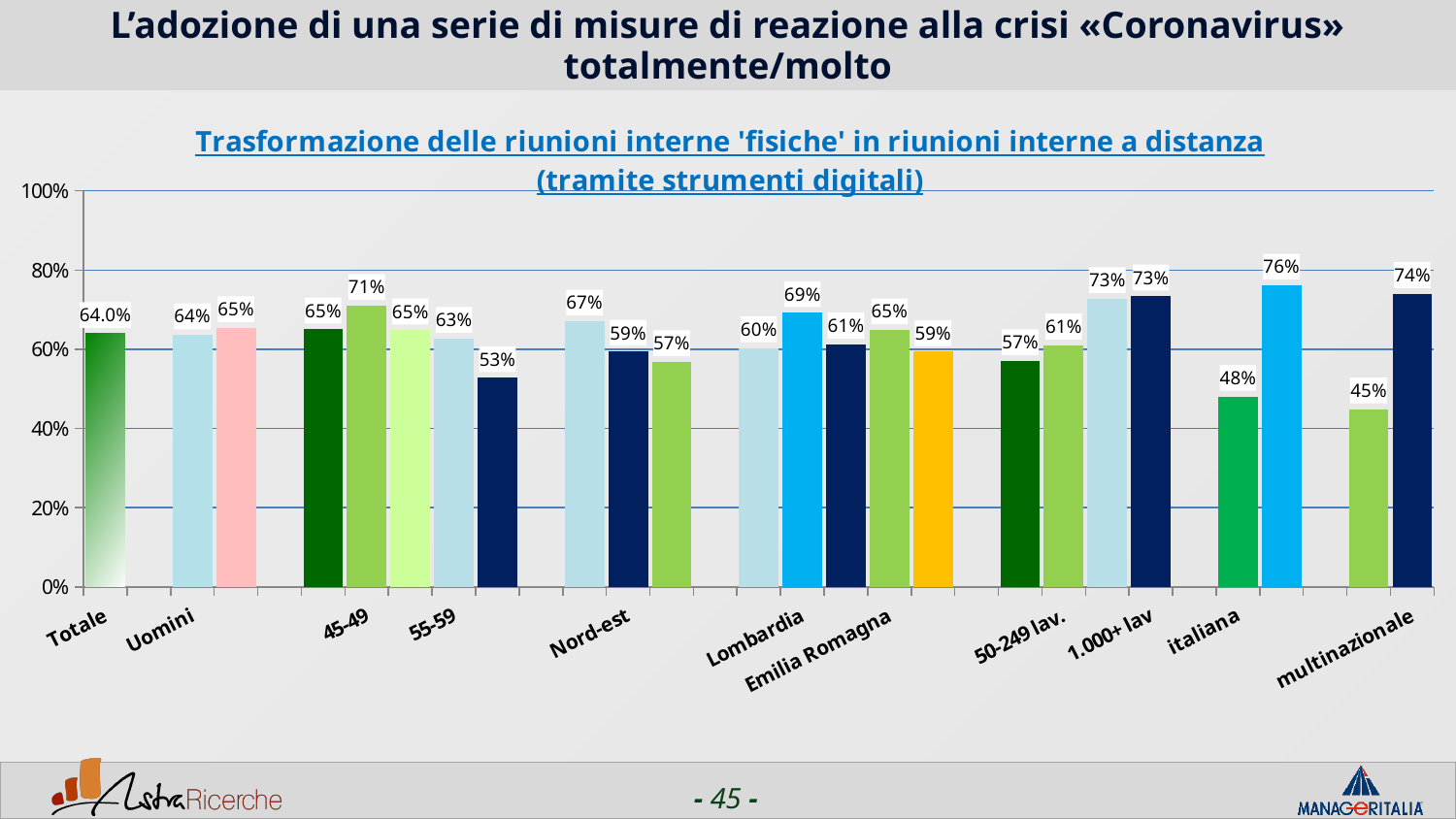
What is the difference between the values for 45-49 and 55-59? 8% What is the value for Uomini? 64% Which is larger, the value for Lombardia or the value for Nord-est? Lombardia What is the title of the chart? Trasformazione delle riunioni interne 'fisiche' in riunioni interne a distanza (tramite strumenti digitali) What is the value for the 55-59 age group? 63% What is the value for Totale? 64.0% What is the value for Emilia Romagna? 65% What is the value for Lombardia? 69% What kind of chart is shown on the slide? bar chart Is the value for 1.000+ lav greater or less than 60%? greater What is the value for 50-249 lav.? 61% What is the value for the 45-49 age group? 71%